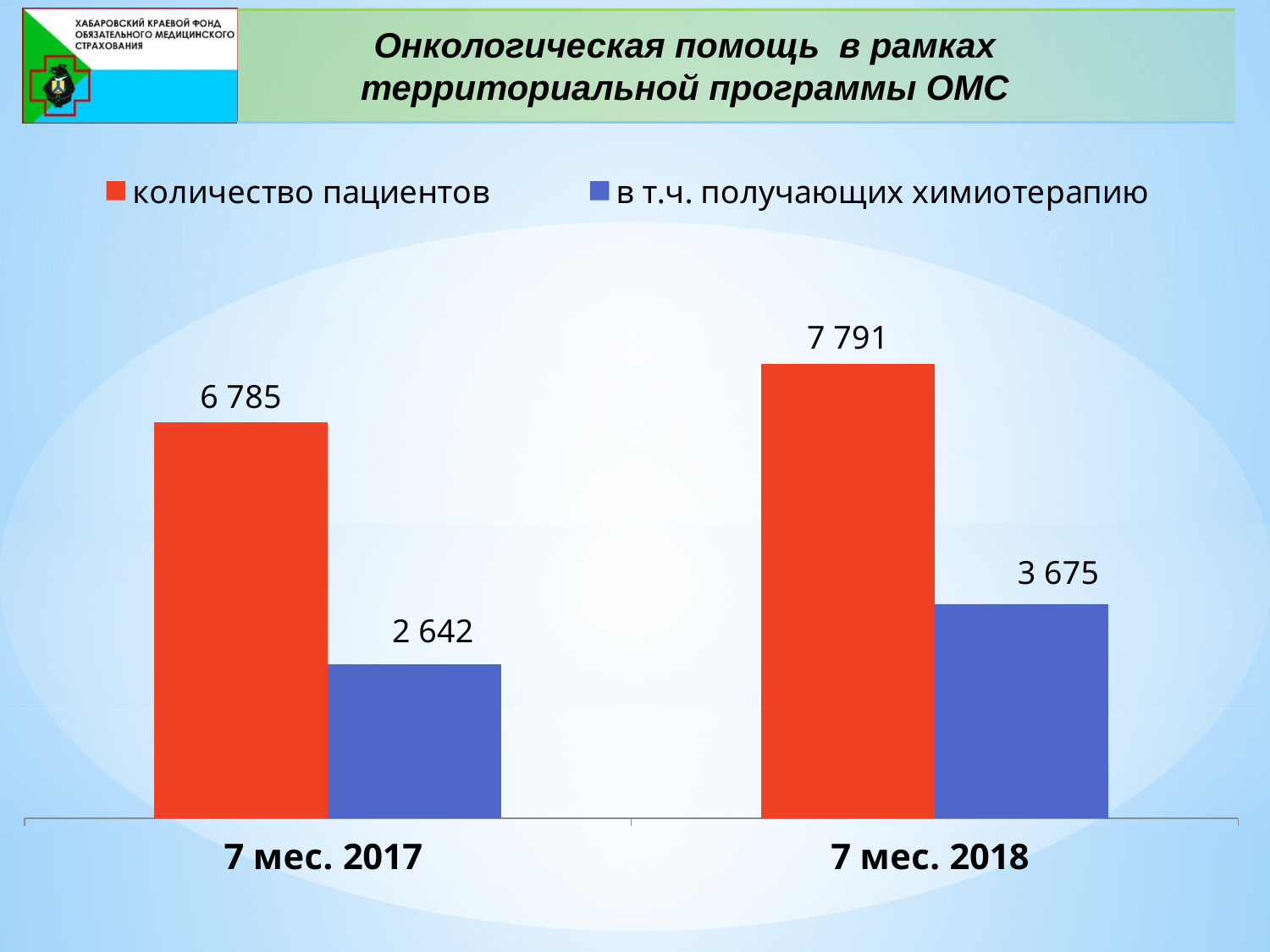
How many categories are shown on the x axis? 2 Which category has the lowest value for "в т.ч. получающих химиотерапию"? 7 мес. 2017 What is the difference between "количество пациентов" for "7 мес. 2018" and "7 мес. 2017"? 1 006 What is the value of "в т.ч. получающих химиотерапию" for "7 мес. 2017"? 2 642 What is the difference between "в т.ч. получающих химиотерапию" for "7 мес. 2018" and "7 мес. 2017"? 1 033 What kind of chart is shown on the slide? bar chart Which is larger: "в т.ч. получающих химиотерапию" for "7 мес. 2018" or "7 мес. 2017"? 7 мес. 2018 What is the value of "количество пациентов" for "7 мес. 2017"? 6 785 How many series does the legend list? 2 What is the value of "количество пациентов" for "7 мес. 2018"? 7 791 Which category has the highest value for "количество пациентов"? 7 мес. 2018 What is the value of "в т.ч. получающих химиотерапию" for "7 мес. 2018"? 3 675